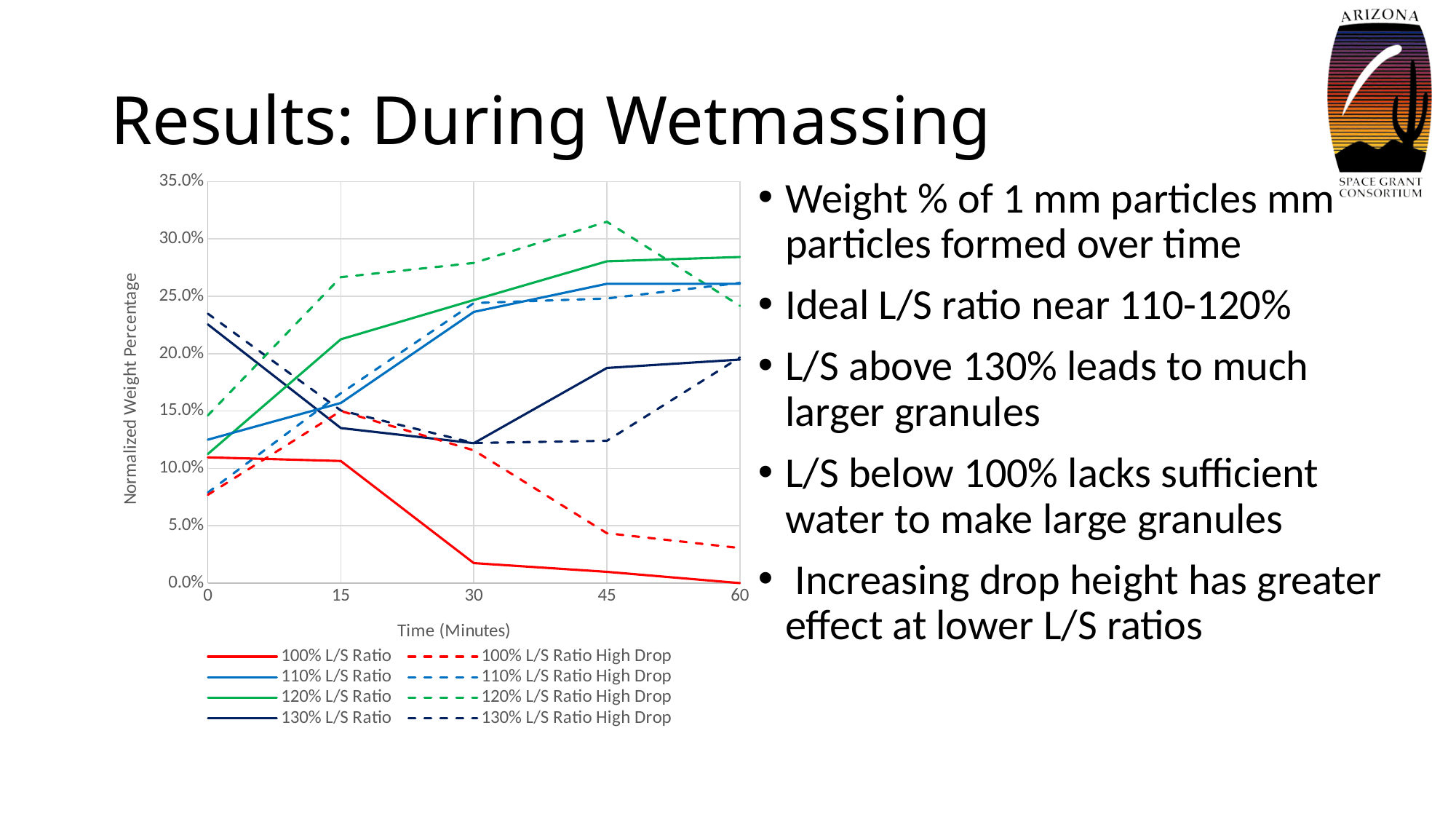
What kind of chart is shown on the slide? Line chart Is the value of the 120% L/S Ratio High Drop series at 45 minutes greater or less than 30.0%? greater Does the 120% L/S Ratio series rise or fall from 0 to 60 minutes? Rise Does the 100% L/S Ratio series rise or fall from 0 to 60 minutes? Fall How many series does the chart legend list? 8 Is the value of the 100% L/S Ratio series at 30 minutes greater or less than 5.0%? less What is the title of the chart's x axis? Time (Minutes) What is the title of the chart's y axis? Normalized Weight Percentage At 60 minutes, which is larger: the 120% L/S Ratio series or the 100% L/S Ratio series? 120% L/S Ratio How many time points are marked on the x axis of the chart? 5 Is the value of the 130% L/S Ratio series at 0 minutes greater or less than 20.0%? greater Which series has the highest value at 45 minutes? 120% L/S Ratio High Drop